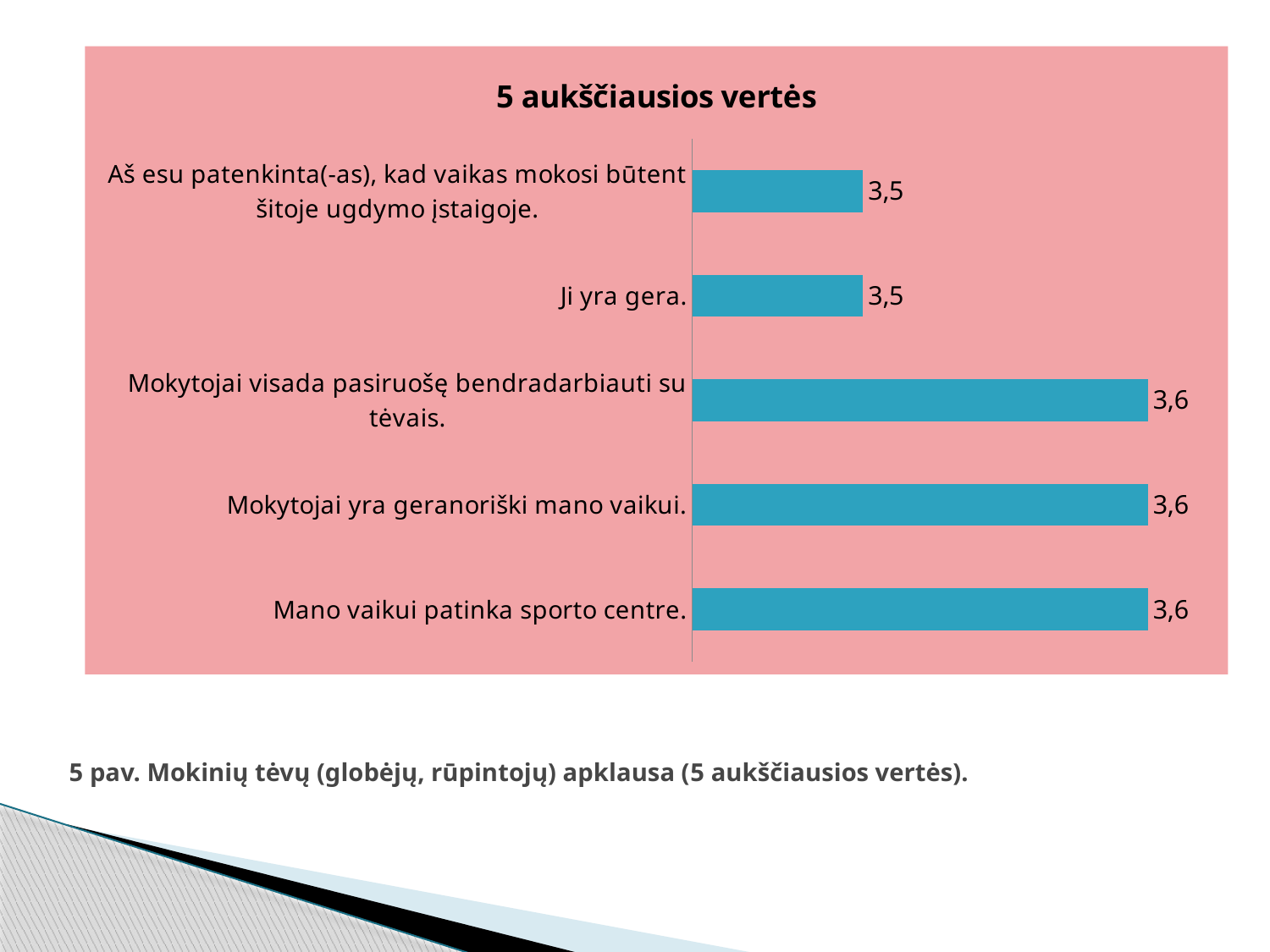
What is the difference between the value for "Mano vaikui patinka sporto centre." and the value for "Ji yra gera."? 0,1 What is the value for "Mokytojai yra geranoriški mano vaikui."? 3,6 What is the value for "Aš esu patenkinta(-as), kad vaikas mokosi būtent šitoje ugdymo įstaigoje."? 3,5 How many categories are shown in the chart? 5 What is the value for "Mokytojai visada pasiruošę bendradarbiauti su tėvais."? 3,6 How many categories in the chart have a value of 3,6? 3 What colour are the bars in the chart? Blue What is the value for "Ji yra gera."? 3,5 What kind of chart is shown on the slide? Bar chart Which is larger, the value for "Mokytojai yra geranoriški mano vaikui." or the value for "Ji yra gera."? Mokytojai yra geranoriški mano vaikui. What is the title of the chart? 5 aukščiausios vertės What is the value for "Mano vaikui patinka sporto centre."? 3,6